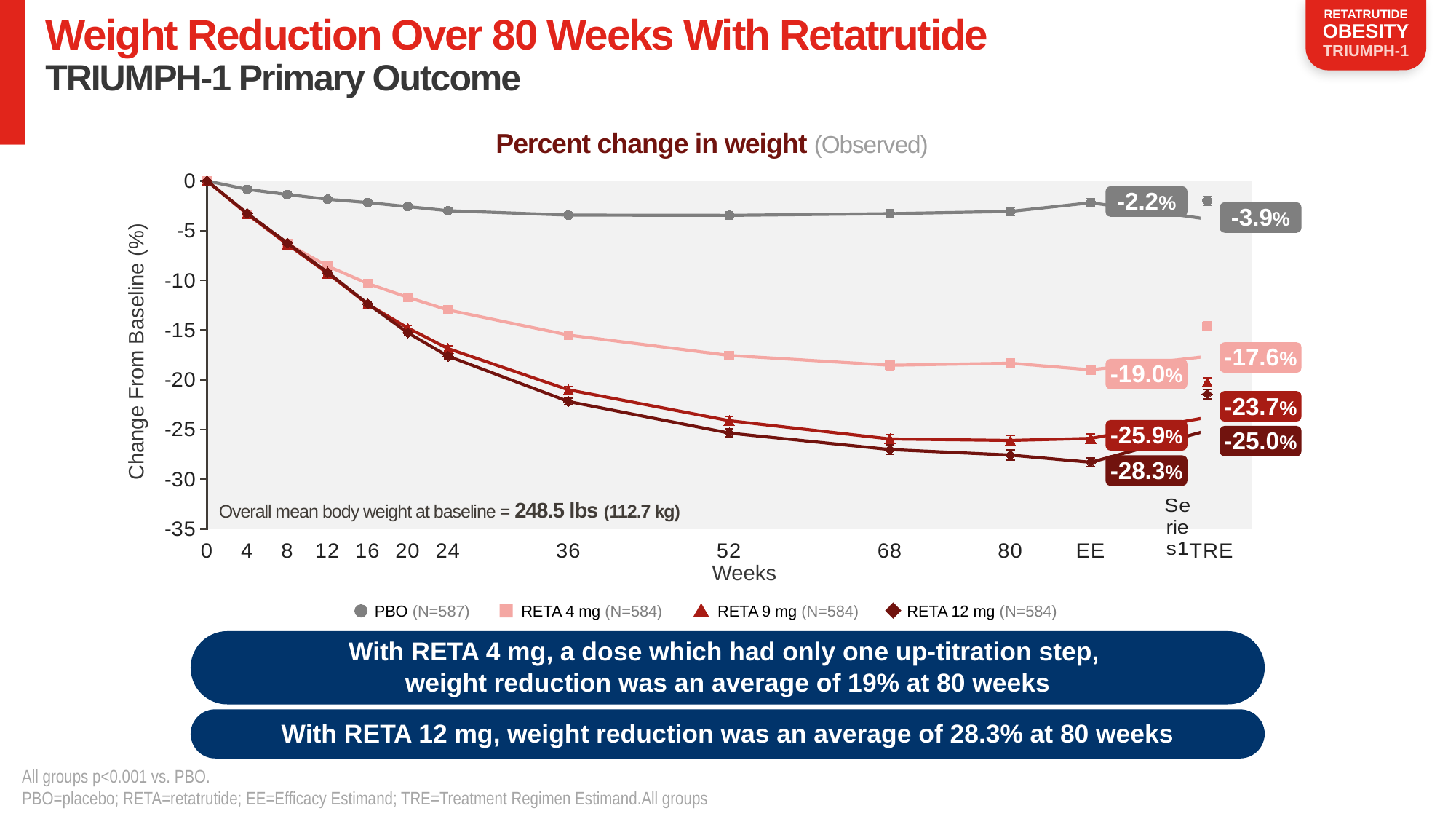
Do the values for RETA 12 mg rise or fall from week 0 to week 80? fall What is the difference between the EE values for RETA 4 mg and RETA 12 mg? 9.3 percentage points Which series has the lowest EE value? RETA 12 mg How many series does the legend list? 4 What is the EE value for PBO? -2.2% Which series has the highest TRE value? PBO What is the EE value for RETA 12 mg? -28.3% Which is larger, the EE value for RETA 9 mg or the EE value for RETA 12 mg? RETA 9 mg What is the TRE value for RETA 9 mg? -23.7% What kind of chart is shown on the slide? line chart Is the value for PBO at week 52 greater or less than -5? greater What is the TRE value for RETA 4 mg? -17.6%